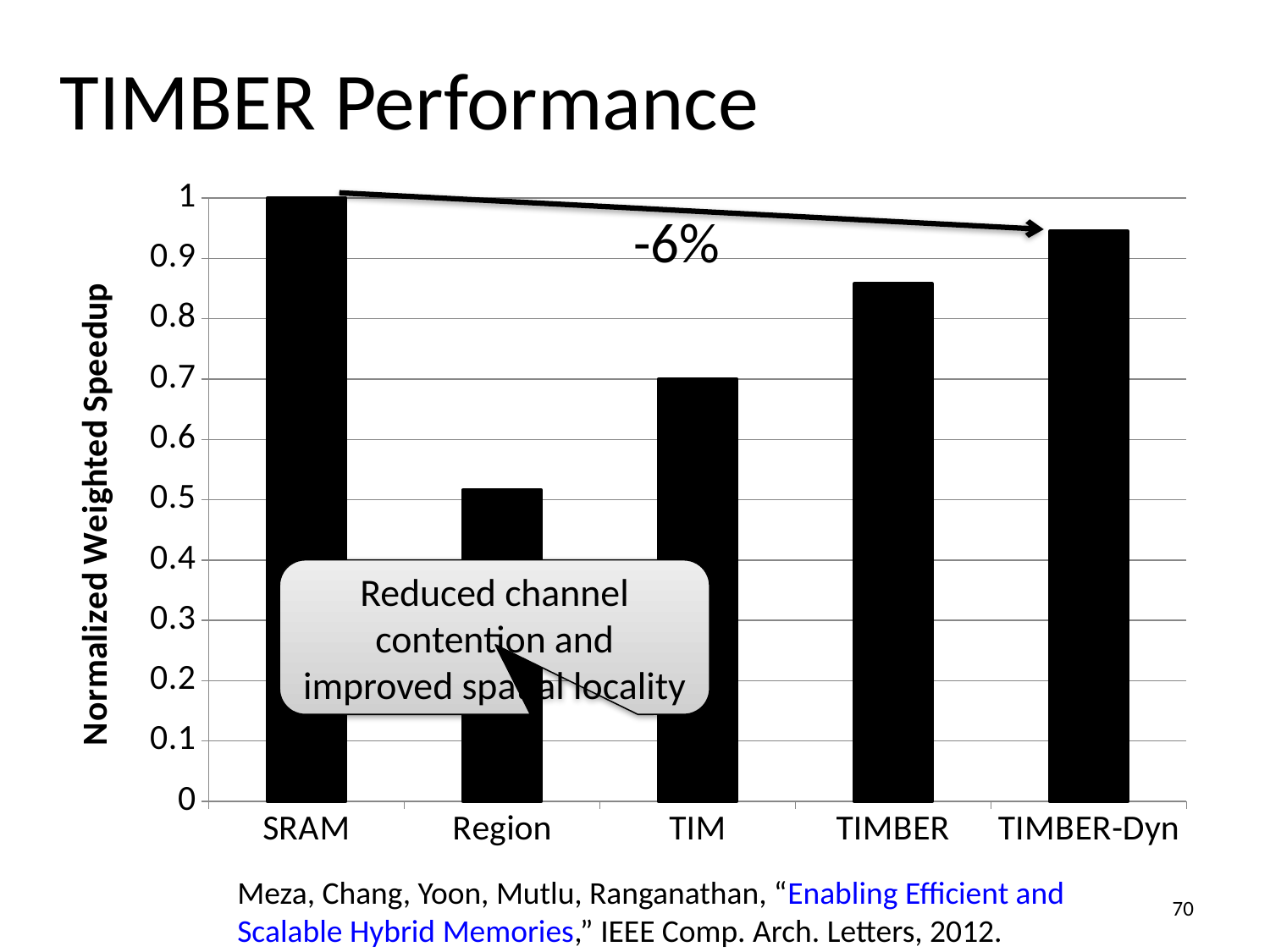
Which category has the highest normalized weighted speedup? SRAM Is the value for TIM greater or less than 0.8? less Which category has the lowest normalized weighted speedup? Region Is the value for Region greater or less than 0.6? less What type of chart is shown on the slide? bar chart What is the normalized weighted speedup for SRAM? 1 How many categories are shown on the x axis of the chart? 5 Is the value for TIMBER greater or less than 0.8? greater What percentage change is annotated by the arrow from SRAM to TIMBER-Dyn? -6% What is the label of the y axis? Normalized Weighted Speedup Which has a larger normalized weighted speedup, TIMBER or TIM? TIMBER